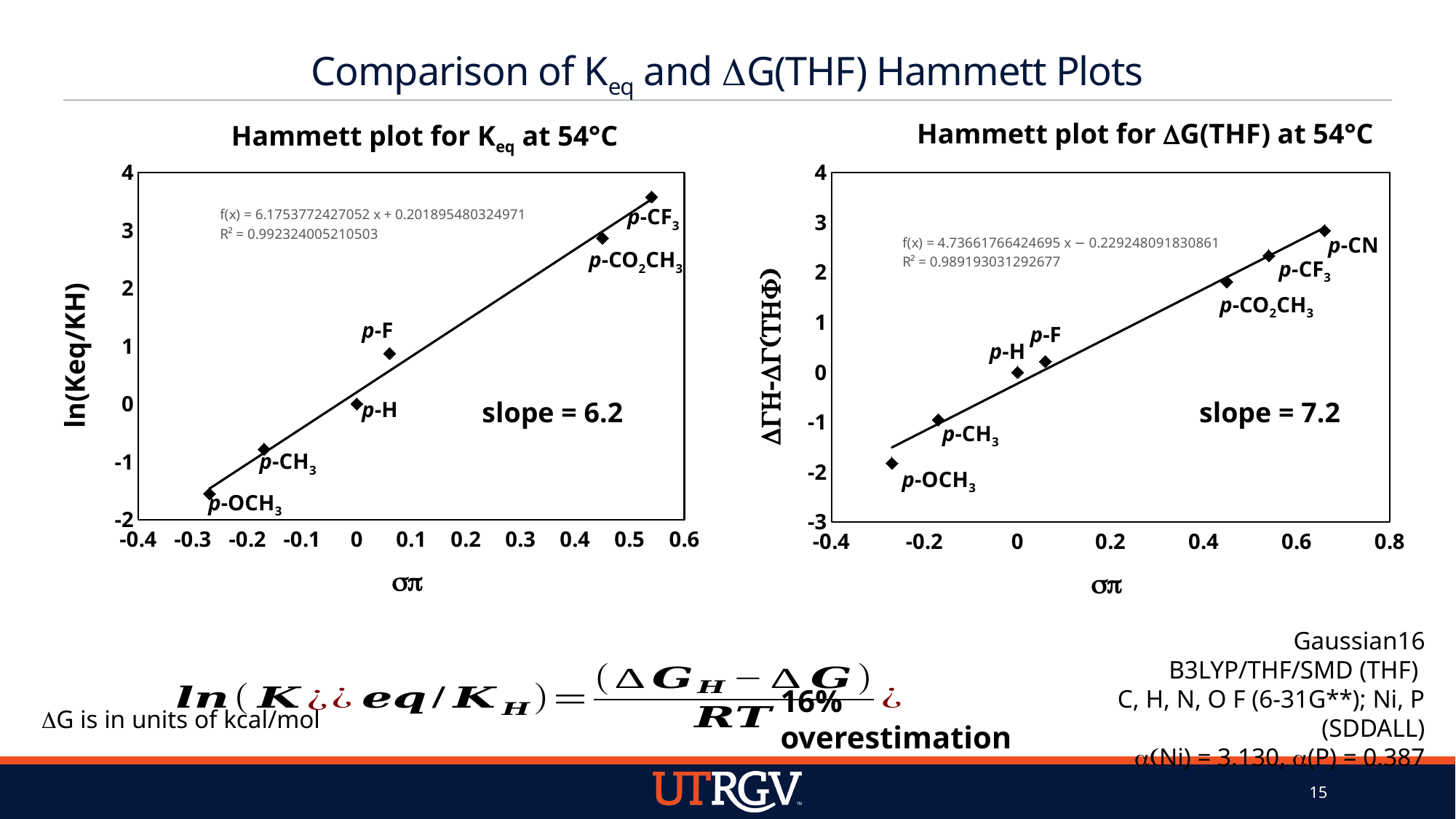
In the 'Hammett plot for ΔG(THF) at 54°C', which substituent has the lowest value? p-OCH3 In the 'Hammett plot for Keq at 54°C', do the values rise or fall as σp increases along the x axis? rise What slope is printed on the 'Hammett plot for ΔG(THF) at 54°C'? slope = 7.2 What type of chart is the 'Hammett plot for Keq at 54°C'? scatter plot In the 'Hammett plot for Keq at 54°C', how many data points are plotted? 6 In the 'Hammett plot for ΔG(THF) at 54°C', which substituent has the highest value? p-CN In the 'Hammett plot for ΔG(THF) at 54°C', how many data points are plotted? 7 In the 'Hammett plot for Keq at 54°C', is the value for p-CF3 greater or less than 3? greater In the 'Hammett plot for ΔG(THF) at 54°C', is the value for p-OCH3 greater or less than -1? less In the 'Hammett plot for Keq at 54°C', which substituent has the lowest ln(Keq/KH) value? p-OCH3 In the 'Hammett plot for Keq at 54°C', which substituent has the highest ln(Keq/KH) value? p-CF3 In the 'Hammett plot for Keq at 54°C', which has the larger value, p-F or p-H? p-F